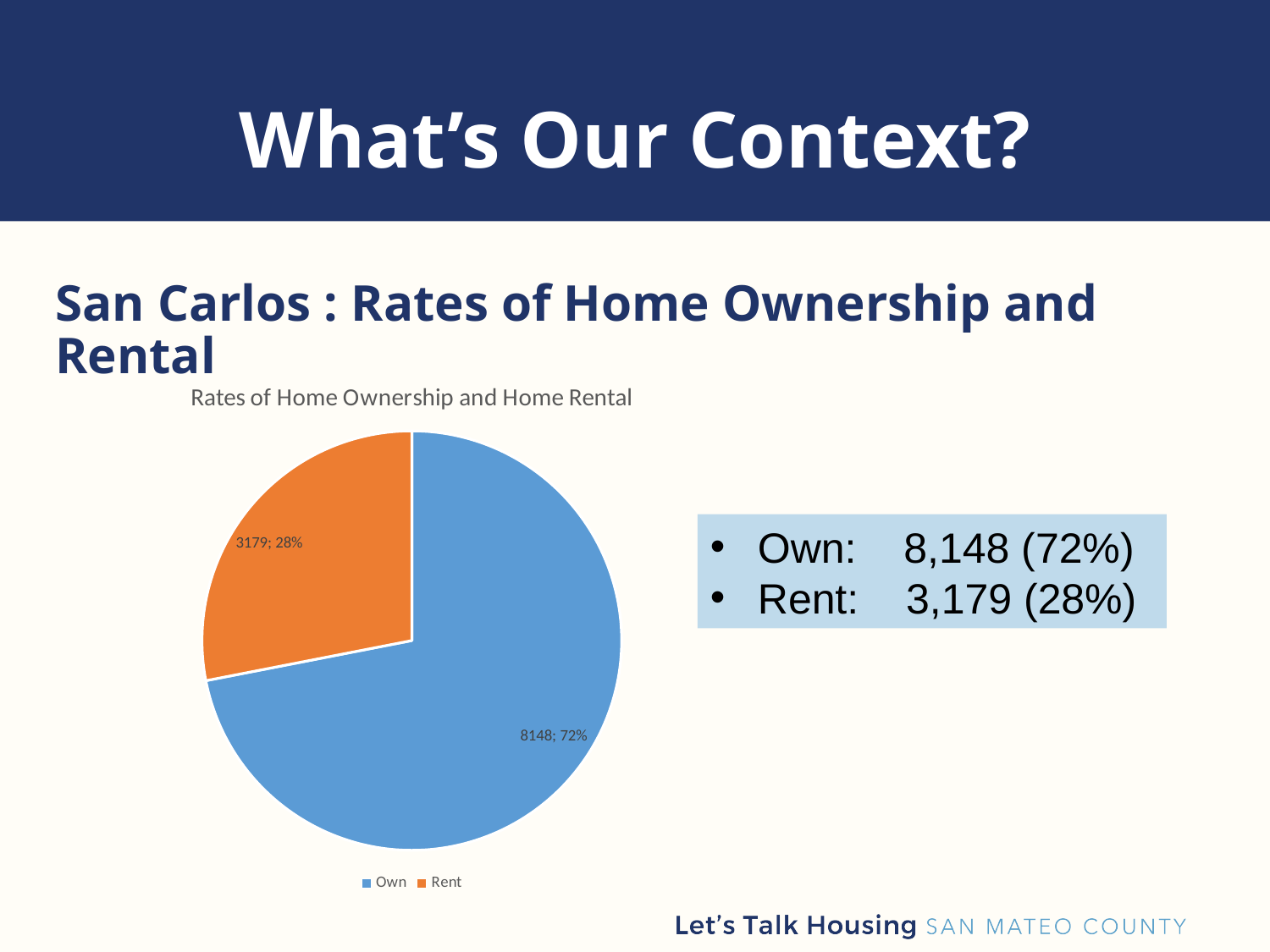
What is the value for Own in the pie chart? 8148 Which category has the smallest slice in the pie chart? Rent What is the title of the pie chart? Rates of Home Ownership and Home Rental How many categories does the pie chart show? 2 What share of the pie does the Rent slice represent? 28% What colour is the Rent slice in the pie chart? orange What is the value for Rent in the pie chart? 3179 Which category has the largest slice in the pie chart? Own What type of chart is shown on the slide? pie chart What share of the pie does the Own slice represent? 72% What is the difference between the Own and Rent values in the pie chart? 4969 Which is larger, the Own slice or the Rent slice? Own